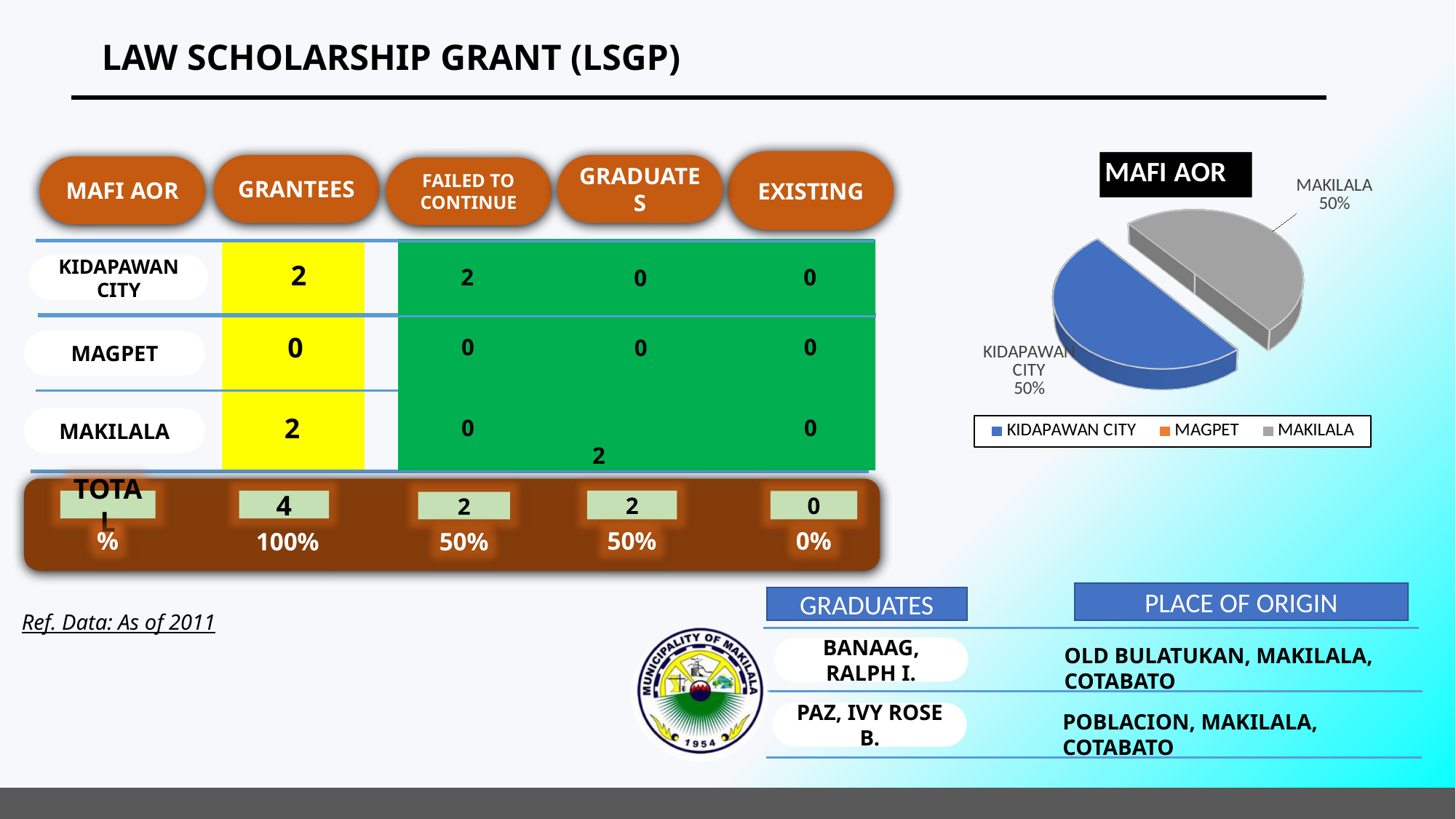
Which legend category has no visible slice in the pie chart? MAGPET How many data series does the pie chart plot? 1 How many slices are visible in the pie chart? 2 What is the difference between the shares of KIDAPAWAN CITY and MAKILALA in the pie chart? 0% What is the percentage label shown for the KIDAPAWAN CITY slice? 50% How many categories does the legend of the pie chart list? 3 What kind of chart is shown on the slide? pie chart What share of the pie chart does KIDAPAWAN CITY represent? 50% What is the title of the pie chart? MAFI AOR What is the percentage label shown for the MAKILALA slice? 50% What share of the pie chart does MAKILALA represent? 50%